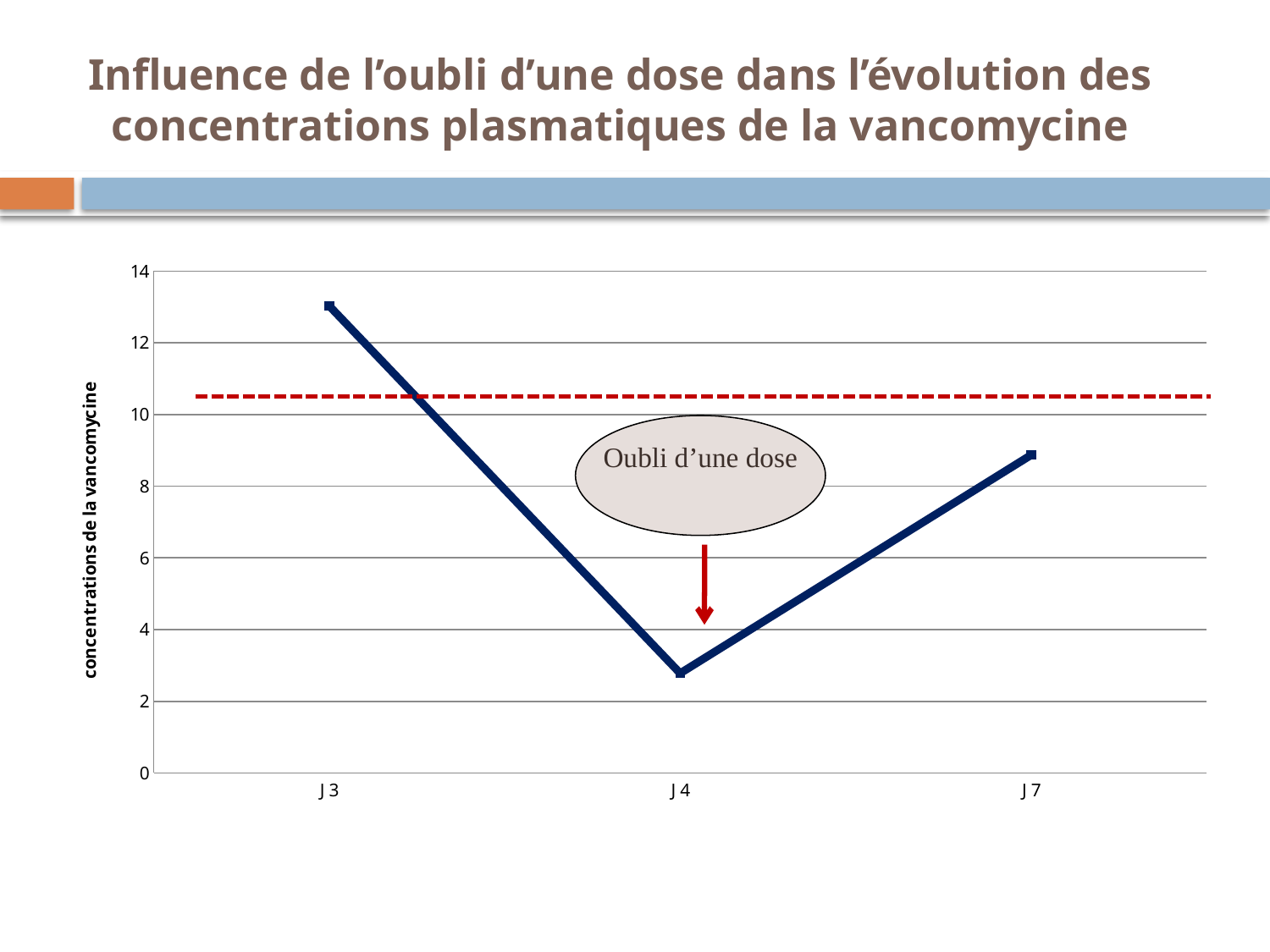
What is the label of the vertical axis? concentrations de la vancomycine Is the concentration at J 4 greater or less than 4? less How many points are plotted on the line? 3 Which day has the lowest vancomycin concentration? J 4 Is the concentration at J 7 greater or less than 8? greater Which day has the highest vancomycin concentration? J 3 What kind of chart is shown on the slide? line chart Does the concentration rise or fall from J 3 to J 4? fall What text is written in the oval annotation pointing to J 4? Oubli d’une dose Does the concentration rise or fall from J 4 to J 7? rise Which is larger, the concentration at J 3 or at J 7? J 3 Is the concentration at J 3 greater or less than 12? greater